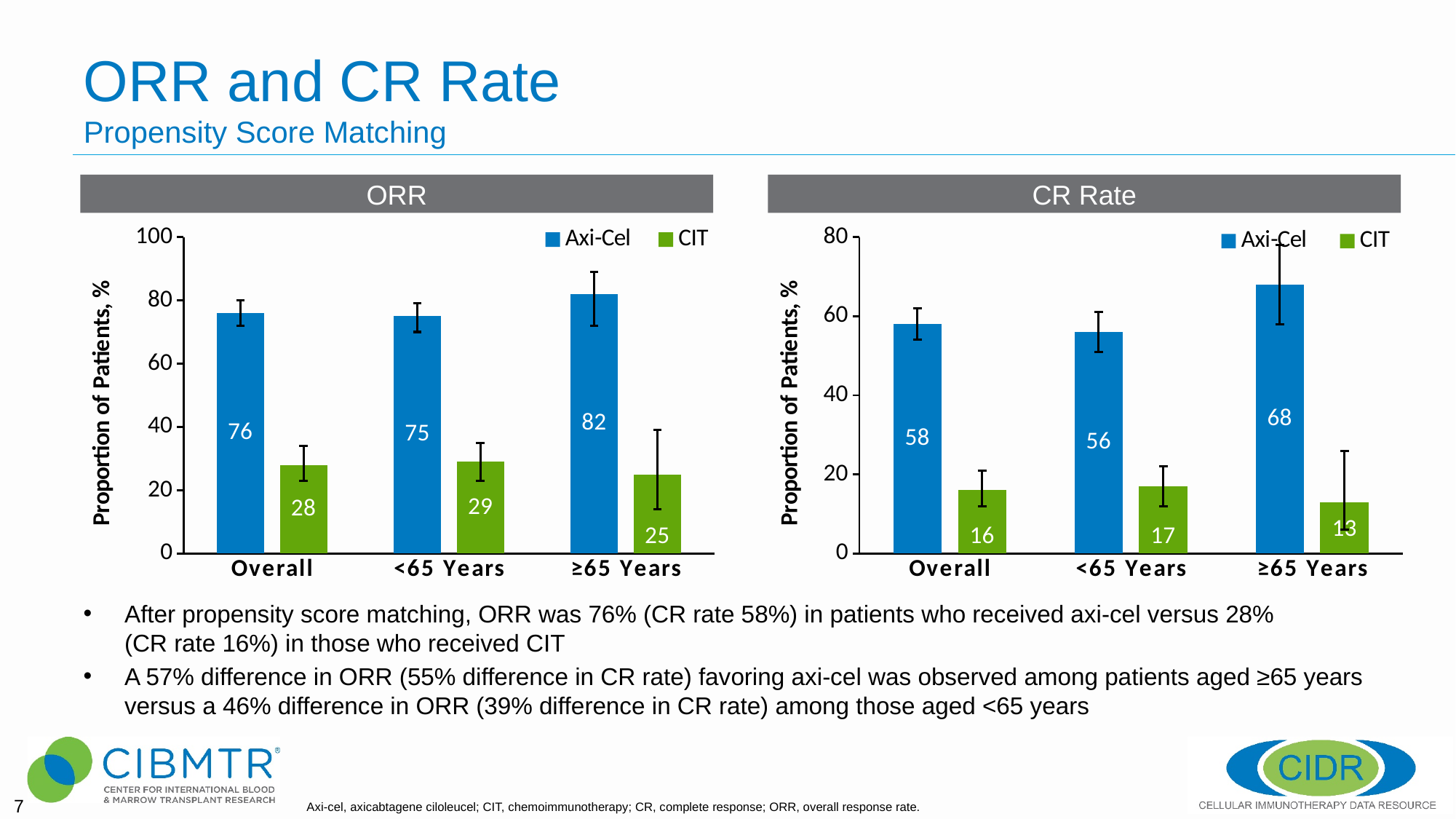
In the CR Rate chart, what is the difference between the Axi-Cel and CIT values in the ≥65 Years category? 55 In the CR Rate chart, which is larger: the Axi-Cel value for Overall or the Axi-Cel value for ≥65 Years? ≥65 Years In the ORR chart, what is the difference between the Axi-Cel and CIT values in the <65 Years category? 46 In the CR Rate chart, what is the value for Axi-Cel in the <65 Years category? 56 How many categories are shown on the x axis of the ORR chart? 3 In the CR Rate chart, what is the value for CIT in the Overall category? 16 How many series does the legend of the CR Rate chart list? 2 In the CR Rate chart, which category has the lowest CIT value? ≥65 Years In the ORR chart, what is the value for CIT in the ≥65 Years category? 25 In the ORR chart, which category has the highest Axi-Cel value? ≥65 Years In the ORR chart, what is the value for Axi-Cel in the Overall category? 76 What type of chart is the ORR chart? Bar chart